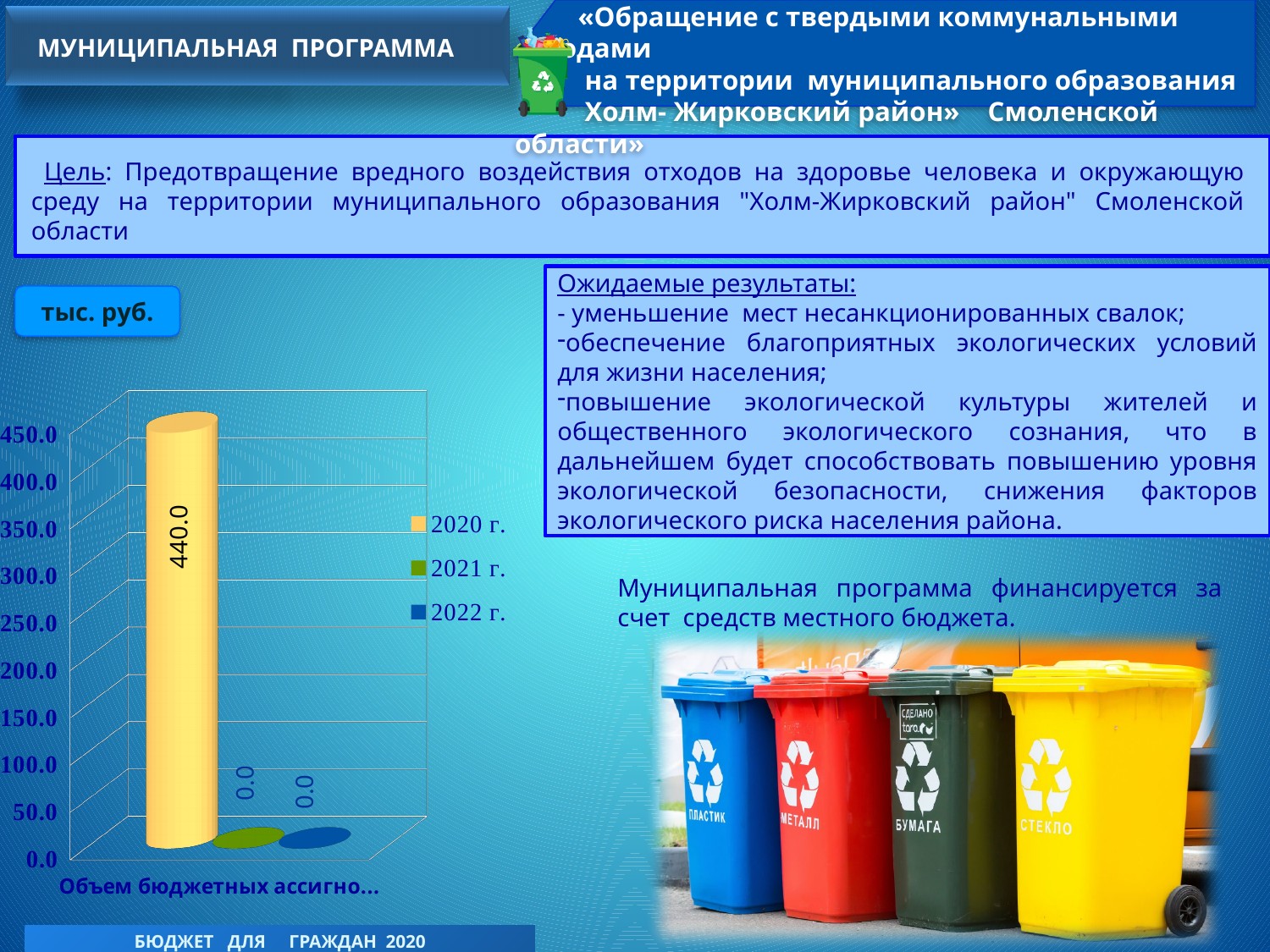
What is the value for the 2020 г. series on the chart? 440.0 Is the value for 2020 г. greater or less than 450.0? less How many series does the legend list? 3 What kind of chart is shown on the slide? bar chart What unit of measurement is indicated for the chart values? тыс. руб. Which series has the highest value on the chart? 2020 г. What is the difference between the 2020 г. value and the 2021 г. value? 440.0 What is the value for the 2021 г. series on the chart? 0.0 What is the value for the 2022 г. series on the chart? 0.0 Is the value for 2020 г. greater or less than 400.0? greater Which is larger, the value for 2020 г. or the value for 2022 г.? 2020 г. What is the highest value shown on the vertical axis of the chart? 450.0